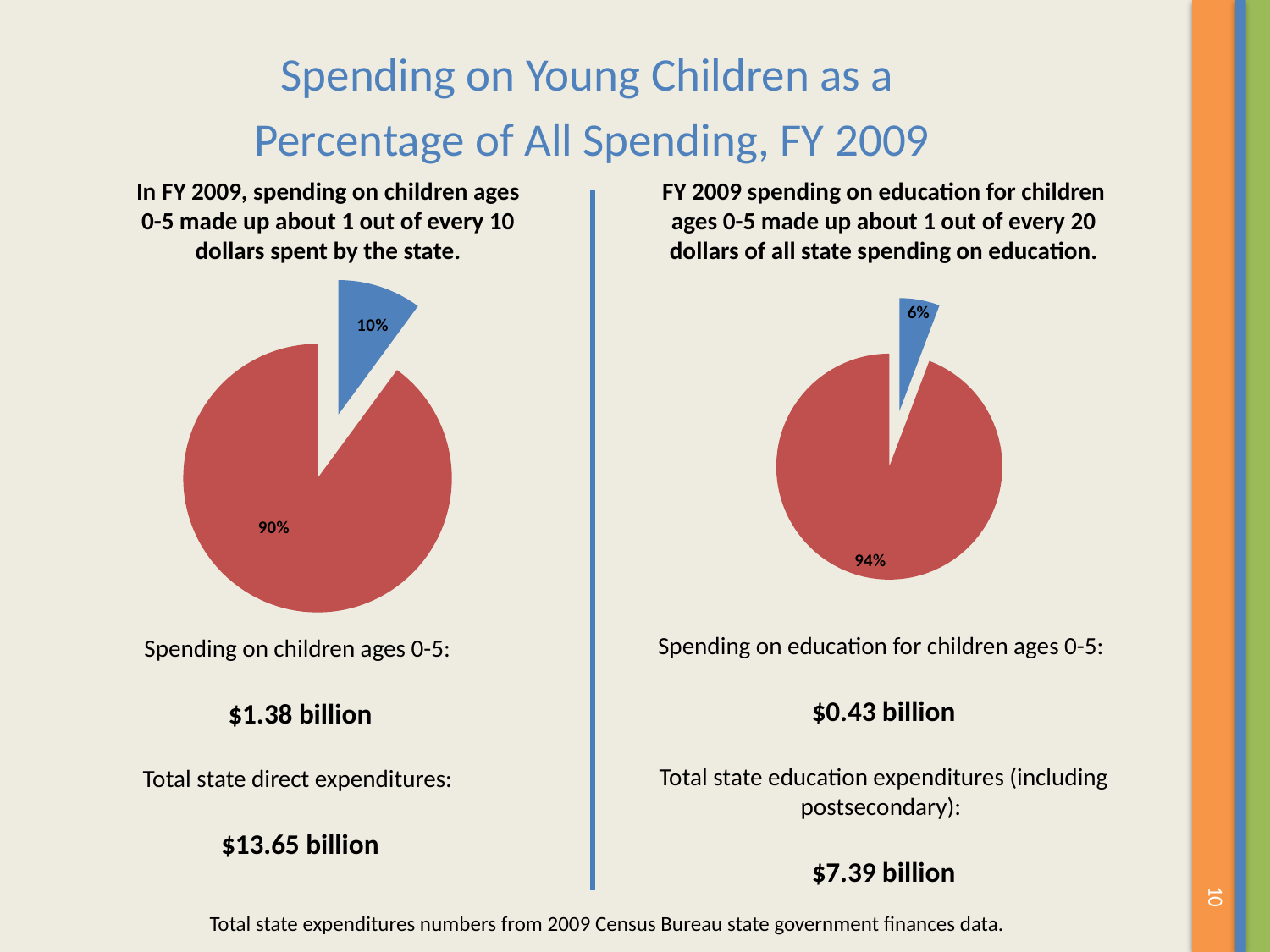
In the right pie chart, what percentage is shown on the blue slice? 6% In the left pie chart, what percentage is shown on the blue slice? 10% Which pie chart has the larger blue slice, the left one or the right one? the left one What is the difference between the red and blue slice percentages in the left pie chart? 80% In the right pie chart, which slice is the smallest? the blue slice (6%) How many charts are on the slide? 2 How many slices does the right pie chart have? 2 In the left pie chart, which slice is larger, the blue one or the red one? red In the left pie chart, what percentage is shown on the red slice? 90% What is the title of the slide containing the two pie charts? Spending on Young Children as a Percentage of All Spending, FY 2009 In the right pie chart, what percentage is shown on the red slice? 94% What kind of chart is shown on the left side of the slide? pie chart